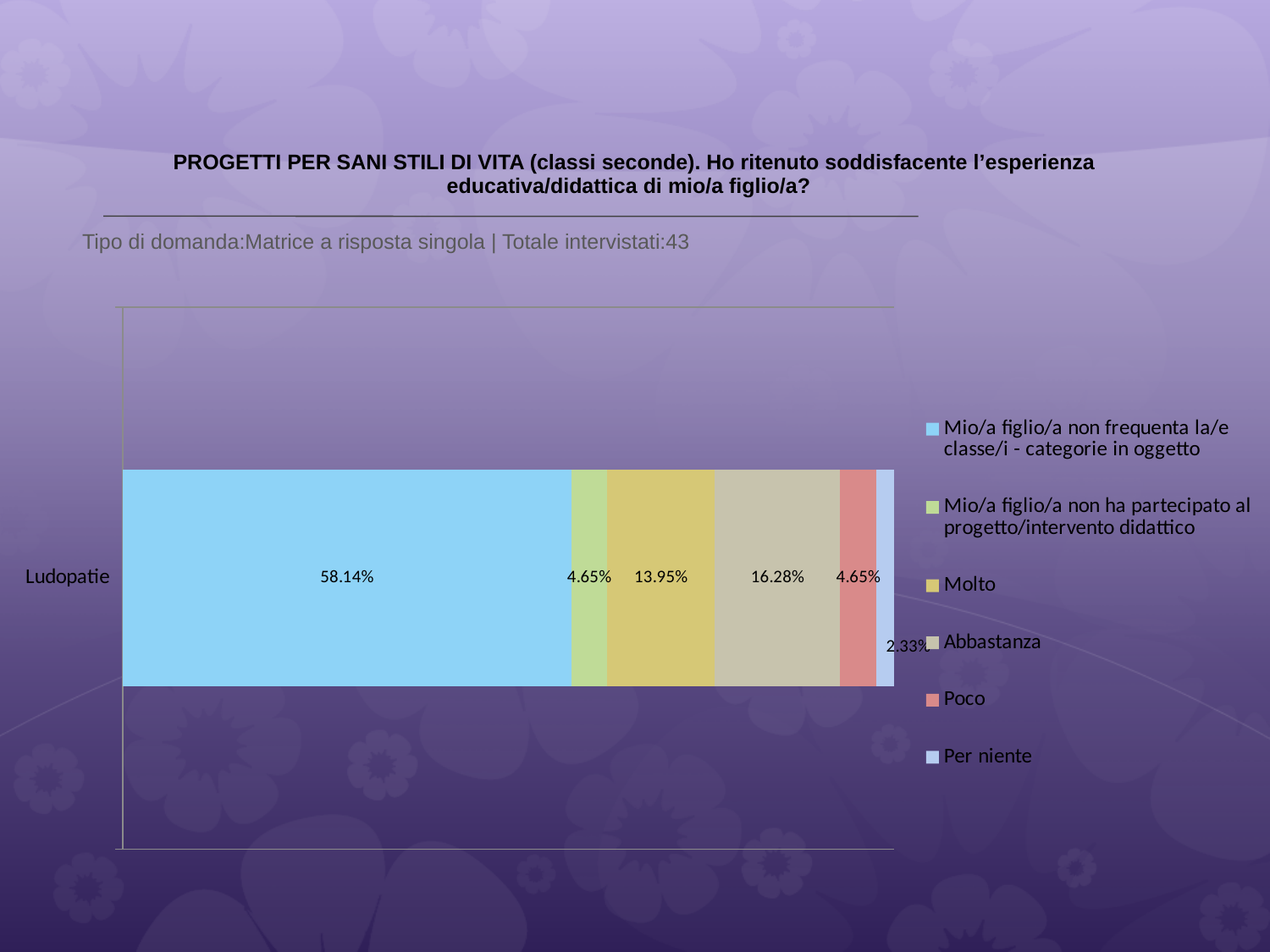
What is the value for 'Mio/a figlio/a non frequenta la/e classe/i - categorie in oggetto' in the Ludopatie bar? 58.14% How many series does the legend list? 6 Which series has the smallest value in the Ludopatie bar? Per niente Which is larger in the Ludopatie bar, 'Abbastanza' or 'Poco'? Abbastanza What is the value for 'Abbastanza' in the Ludopatie bar? 16.28% What type of chart is shown on the slide? bar chart What is the category label shown on the chart's axis? Ludopatie Which series has the largest value in the Ludopatie bar? Mio/a figlio/a non frequenta la/e classe/i - categorie in oggetto What is the value for 'Per niente' in the Ludopatie bar? 2.33% What is the value for 'Molto' in the Ludopatie bar? 13.95% What is the difference between the 'Abbastanza' and 'Molto' values in the Ludopatie bar? 2.33% How many categories are plotted on the chart? 1